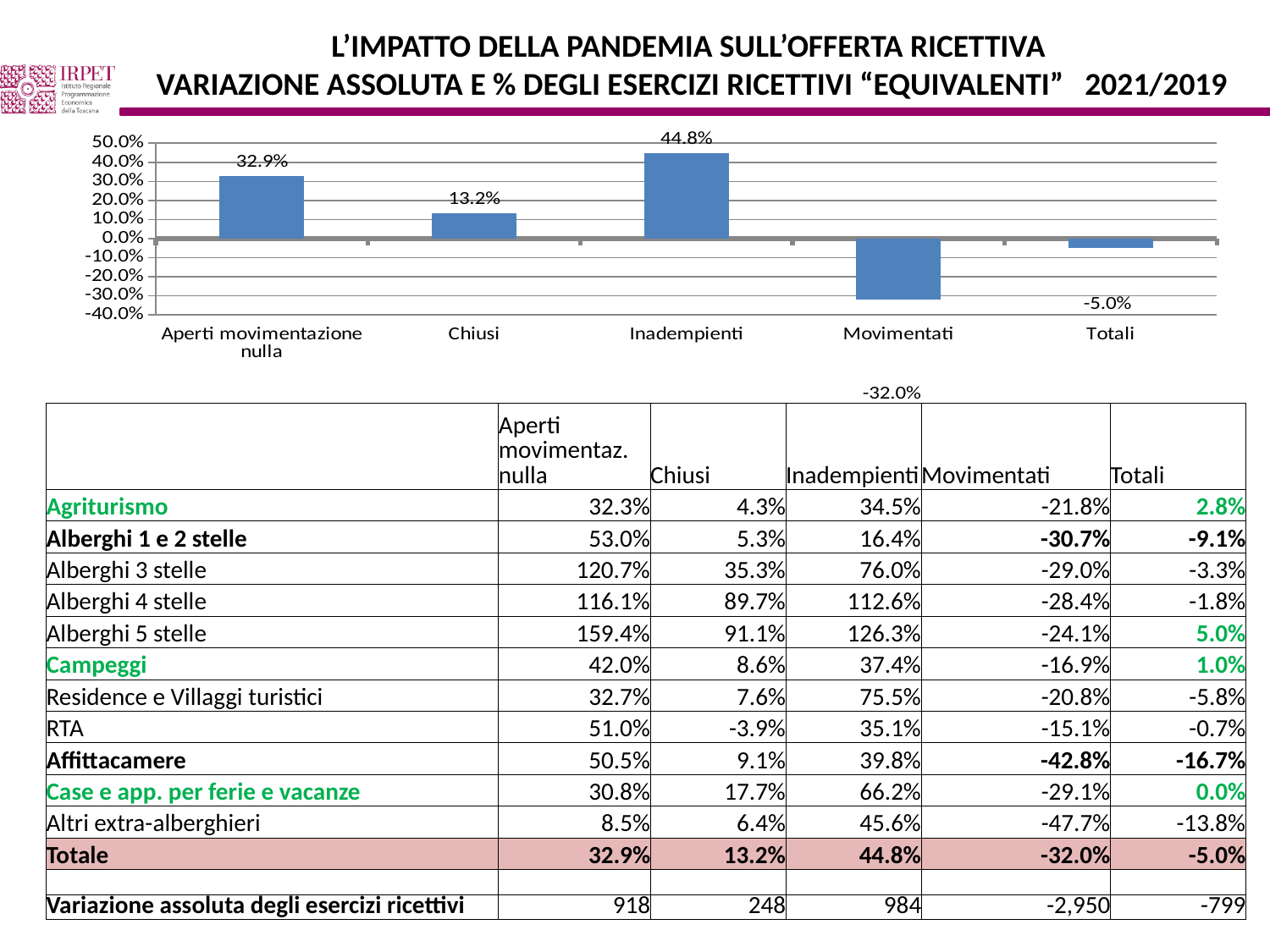
Which is larger in the bar chart, the value for Aperti movimentazione nulla or the value for Chiusi? Aperti movimentazione nulla What is the value for Inadempienti in the bar chart? 44.8% Is the value for Movimentati in the bar chart greater or less than -20.0%? less What is the value for Totali in the bar chart? -5.0% What is the value for Movimentati in the bar chart? -32.0% What is the value for Chiusi in the bar chart? 13.2% What kind of chart is shown on the slide? bar chart What is the value for Aperti movimentazione nulla in the bar chart? 32.9% Which category has the lowest value in the bar chart? Movimentati Which category has the highest value in the bar chart? Inadempienti How many categories are shown in the bar chart? 5 What is the difference between the values for Inadempienti and Chiusi in the bar chart? 31.6%